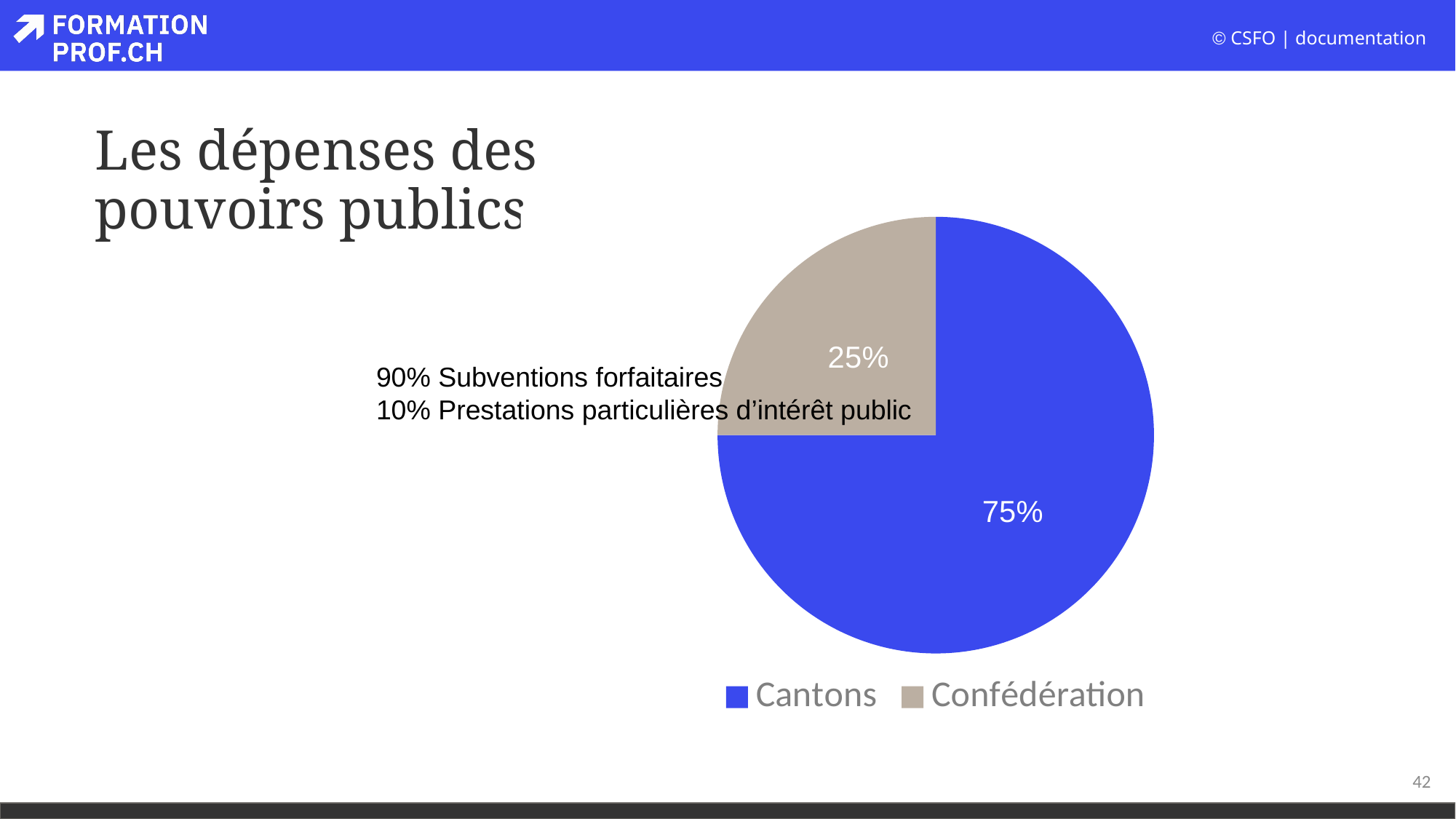
Which category has the smallest slice of the pie? Confédération How many slices does the pie chart have? 2 What share of the pie does Confédération represent? 25% What share of the pie does Cantons represent? 75% What colour is the Cantons slice? Blue How many entries does the legend list? 2 Which is larger, the Cantons slice or the Confédération slice? Cantons Which category has the largest slice of the pie? Cantons What is the difference in percentage points between the Cantons slice and the Confédération slice? 50 What is the title of the slide containing the chart? Les dépenses des pouvoirs publics What kind of chart is shown on the slide? Pie chart